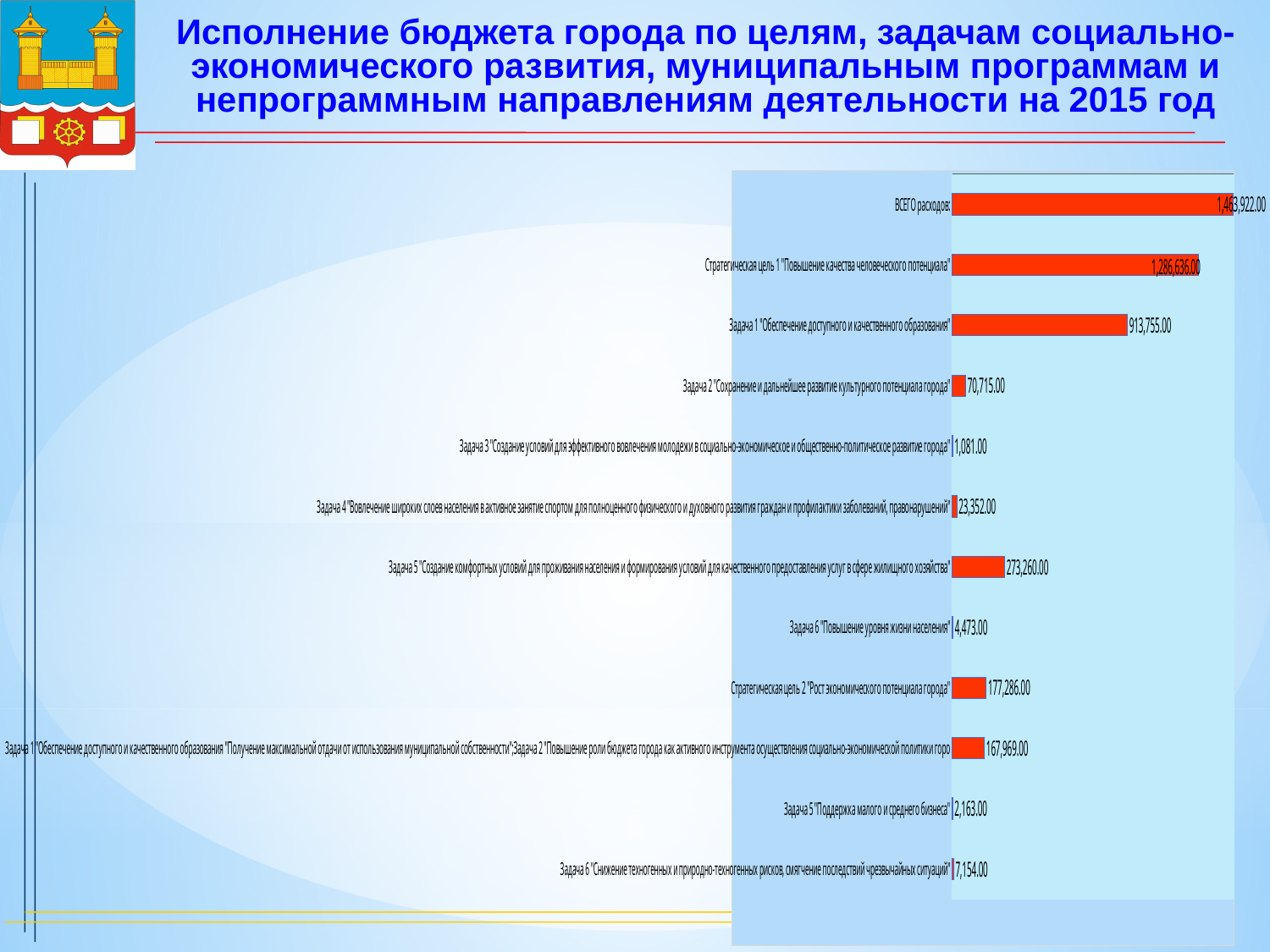
What kind of chart is shown on the slide? Bar chart What is the difference between Стратегическая цель 2 "Рост экономического потенциала города" and Задача 5 "Поддержка малого и среднего бизнеса"? 175,123.00 What is the value for Задача 6 "Повышение уровня жизни населения"? 4,473.00 How many categories (bars) does the chart show? 12 What is the value for "ВСЕГО расходов"? 1,463,922.00 Which category has the highest value? ВСЕГО расходов What is the difference between "ВСЕГО расходов" and Стратегическая цель 1 "Повышение качества человеческого потенциала"? 177,286.00 Which is larger: Задача 2 "Сохранение и дальнейшее развитие культурного потенциала города" or Задача 4 "Вовлечение широких слоев населения в активное занятие спортом..."? Задача 2 "Сохранение и дальнейшее развитие культурного потенциала города" What is the value for Стратегическая цель 1 "Повышение качества человеческого потенциала"? 1,286,636.00 What is the value for Задача 5 "Поддержка малого и среднего бизнеса"? 2,163.00 What is the value for Задача 1 "Обеспечение доступного и качественного образования"? 913,755.00 Which category has the lowest value? Задача 3 "Создание условий для эффективного вовлечения молодежи в социально-экономическое и общественно-политическое развитие города"